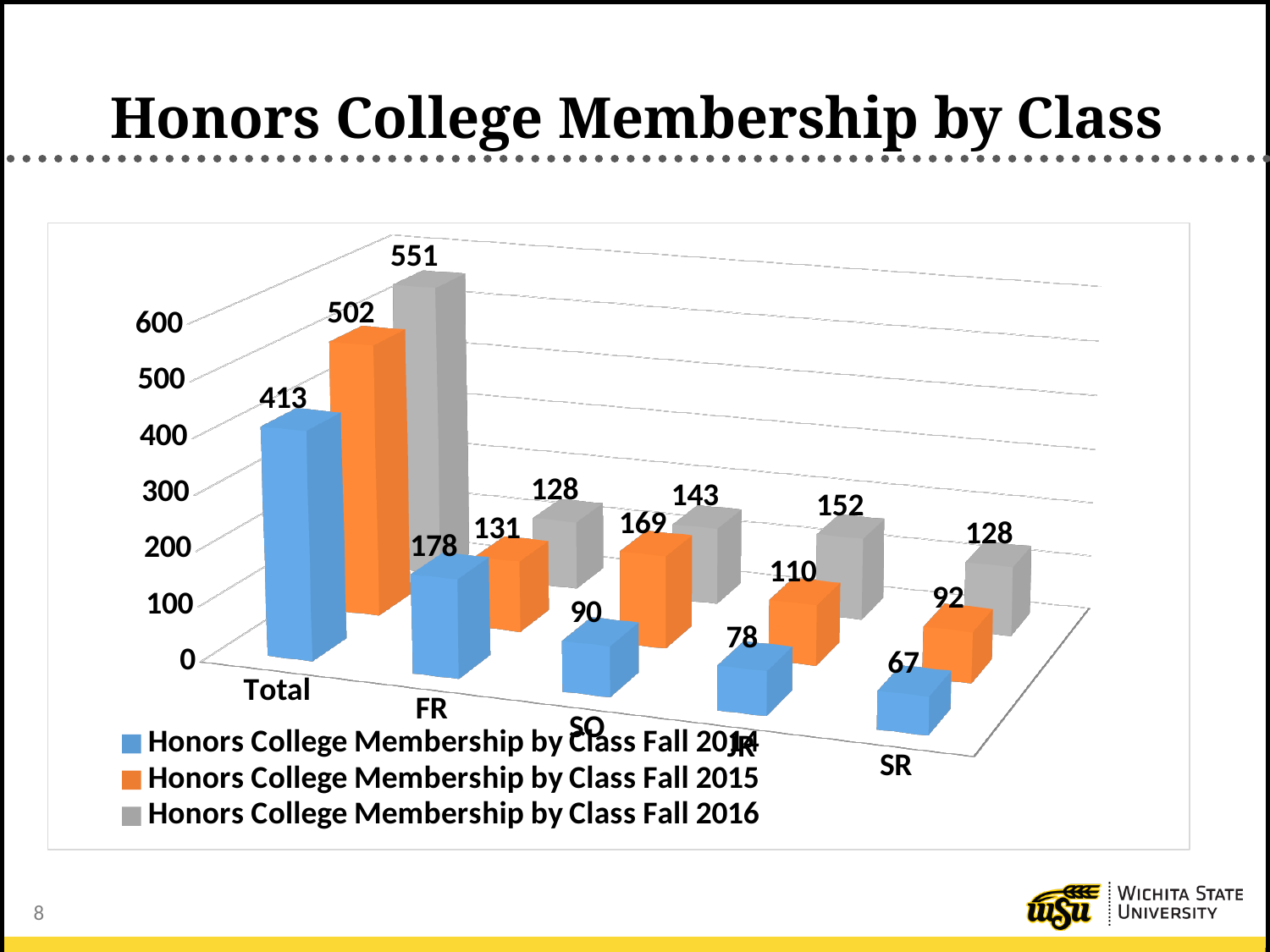
What is the Honors College membership for FR in Fall 2014? 178 How many categories are shown on the x axis? 5 What kind of chart is shown on the slide? Bar chart What is the Total Honors College membership for Fall 2015? 502 What is the difference between the Total membership in Fall 2016 and Fall 2014? 138 What is the Honors College membership for JR in Fall 2016? 152 What is the Honors College membership for SR in Fall 2014? 67 How many series does the legend list? 3 Which colour represents Honors College Membership by Class Fall 2016? Gray Which class (excluding Total) has the highest membership in Fall 2015? SO Which class has the lowest membership in Fall 2014? SR Which is larger, the SO membership in Fall 2015 or the SO membership in Fall 2016? Fall 2015